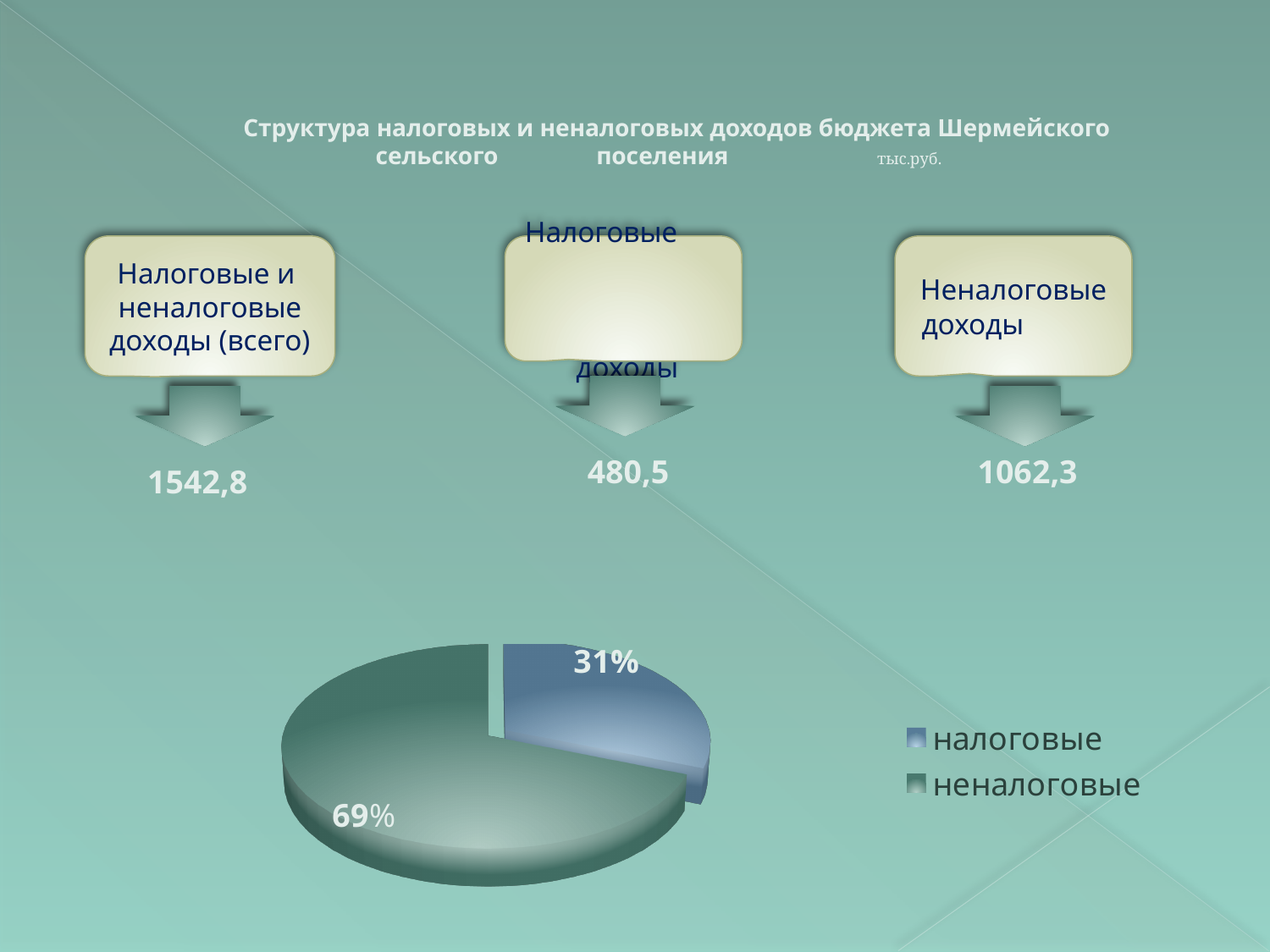
What kind of chart is shown on the slide? pie chart What colour is the "налоговые" slice in the pie chart? blue Which slice of the pie chart is the smallest? налоговые What colour is the "неналоговые" slice in the pie chart? green What share of the pie does the "налоговые" slice represent? 31% How many slices does the pie chart have? 2 Is the share of the "налоговые" slice greater or less than 50%? less Which slice of the pie chart is the largest? неналоговые What share of the pie does the "неналоговые" slice represent? 69% How many entries does the legend of the pie chart list? 2 Which is larger in the pie chart, "налоговые" or "неналоговые"? неналоговые What is the difference in percentage points between the "неналоговые" and "налоговые" slices? 38